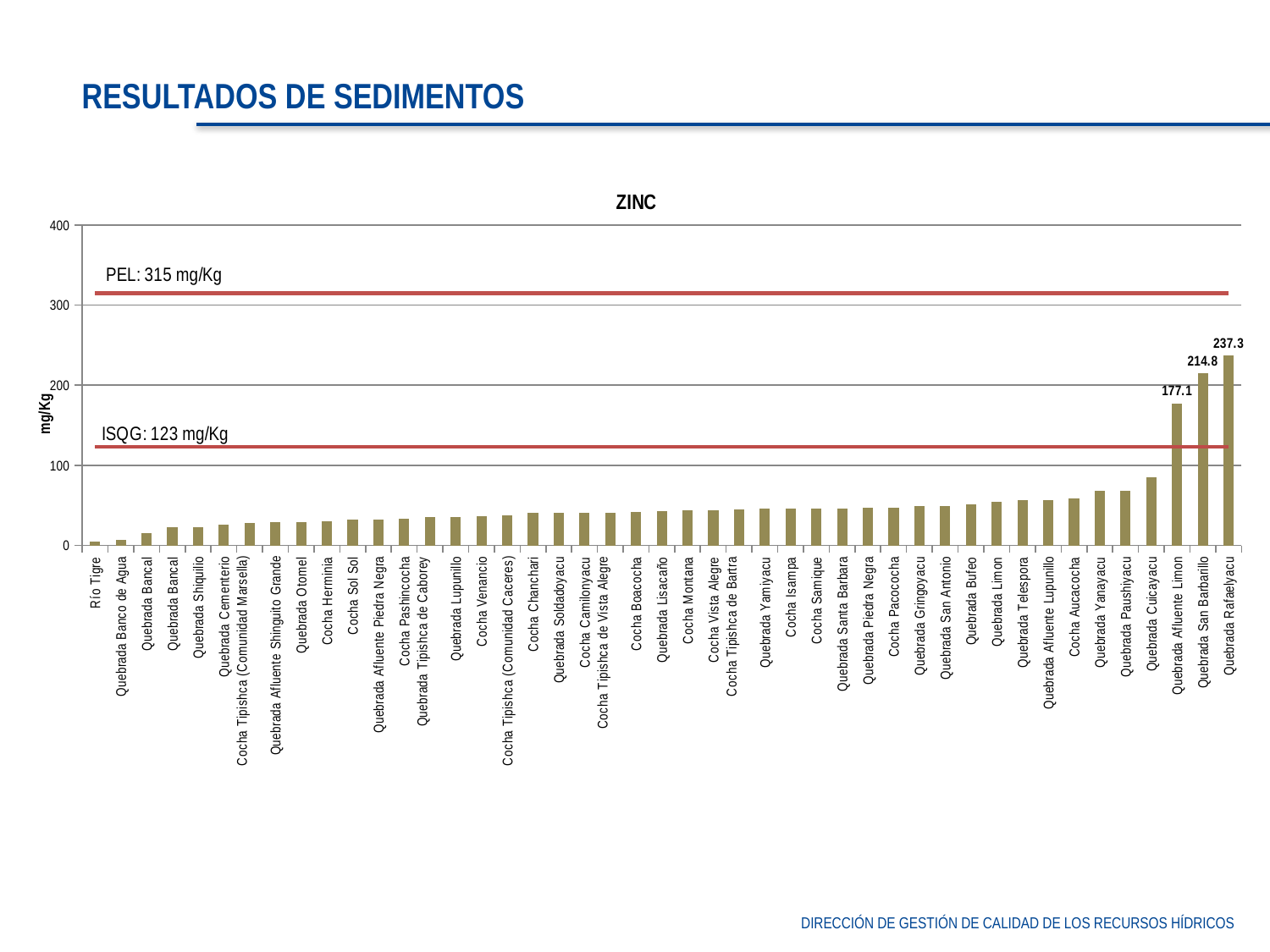
What is the zinc value for Quebrada San Barbarillo? 214.8 What is the zinc value for Quebrada Rafaelyacu? 237.3 Do the zinc values rise or fall from left to right along the x axis? rise What is the PEL reference value shown on the chart? 315 mg/Kg What is the zinc value for Quebrada Afluente Limon? 177.1 Which site has the highest zinc value? Quebrada Rafaelyacu Is the zinc value for Quebrada Cuicayacu greater or less than 100? less Which has a higher zinc value, Quebrada San Barbarillo or Quebrada Afluente Limon? Quebrada San Barbarillo What is the difference between the zinc values for Quebrada Rafaelyacu and Quebrada San Barbarillo? 22.5 What is the difference between the zinc values for Quebrada Rafaelyacu and Quebrada Afluente Limon? 60.2 What kind of chart is shown on the slide? bar chart Which site has the lowest zinc value? Río Tigre